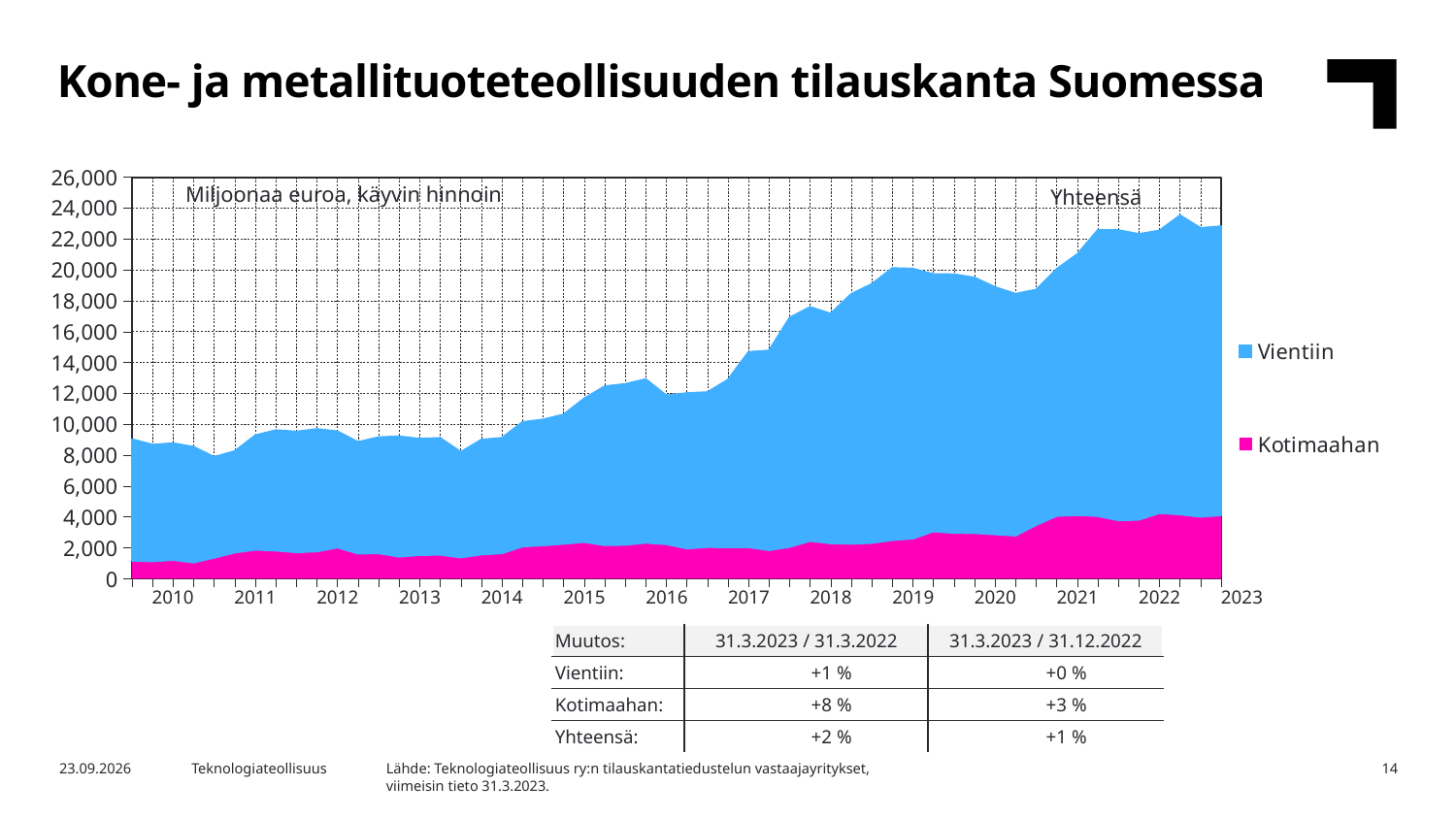
Does the total order backlog (Yhteensä) generally rise or fall from 2010 to 2023? rise What unit is stated in the label at the top left of the plot area? Miljoonaa euroa, käyvin hinnoin Is the Kotimaahan value at the start of 2010 greater or less than 2,000? less Is the total (Yhteensä) value in 2016 greater or less than 10,000? greater How many series does the chart legend list? 2 Is the total (Yhteensä) value in 2022 greater or less than 20,000? greater How many year labels are shown on the x axis? 14 Which two series are listed in the chart legend? Vientiin and Kotimaahan Which series occupies the larger part of the stacked area throughout the chart, Vientiin or Kotimaahan? Vientiin Is the total (Yhteensä) value larger in 2022 or in 2010? 2022 What kind of chart is shown on the slide? Stacked area chart